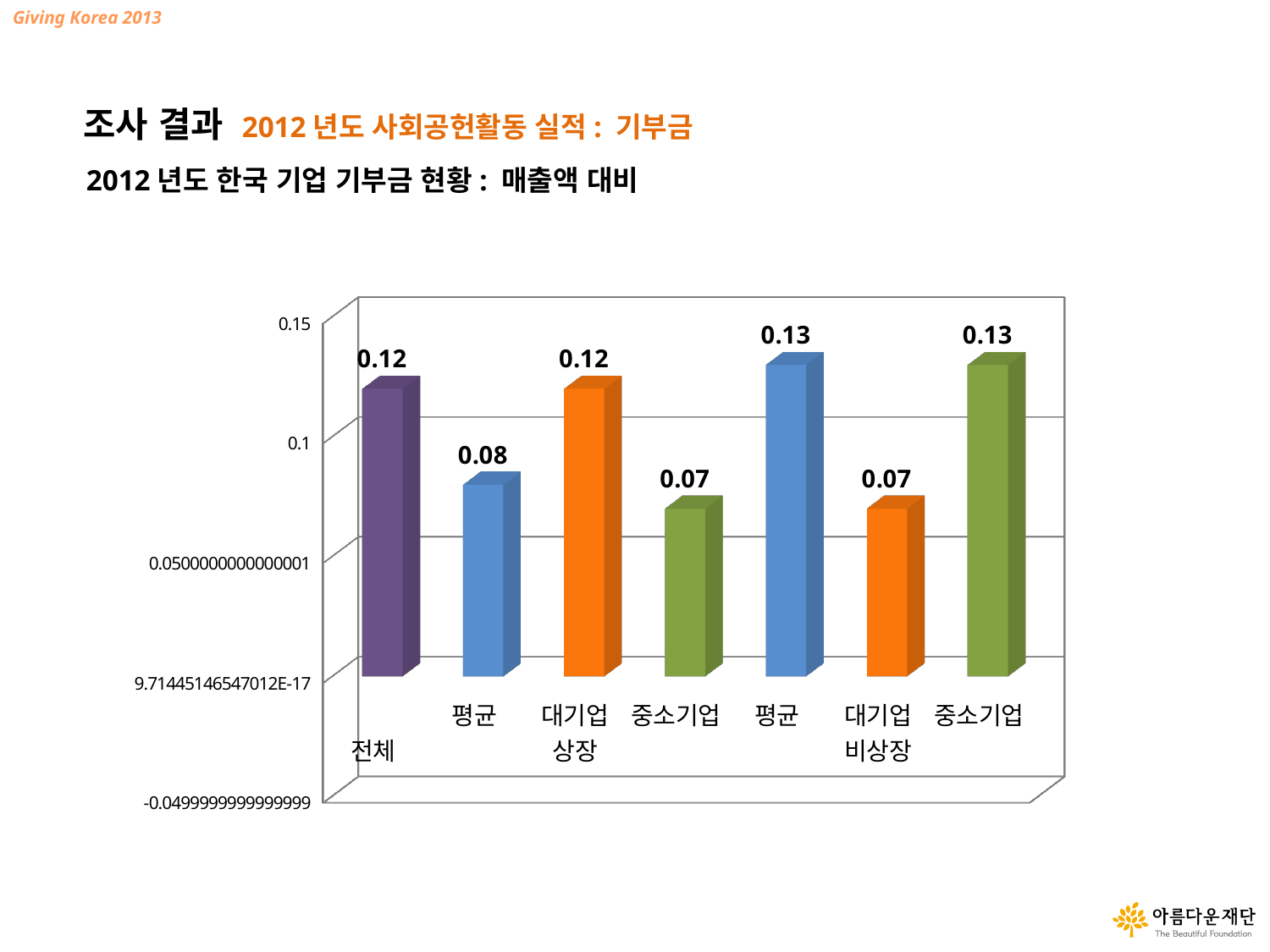
What is the value for 중소기업 in the 비상장 group (rightmost bar)? 0.13 What is the value for 대기업 상장? 0.12 What is the title of the chart? 2012 년도 한국 기업 기부금 현황 : 매출액 대비 What is the value for the 평균 bar in the 상장 group (second bar from the left)? 0.08 How many bars are plotted in the chart? 7 Which is larger, the value for 대기업 상장 or the value for 중소기업 in the 상장 group? 대기업 상장 Is the value for 전체 greater or less than 0.1? greater What is the difference between the 평균 bar in the 비상장 group and the 대기업 비상장 bar? 0.06 What kind of chart is shown on the slide? bar chart What is the difference between the value for 전체 and the value for the 평균 bar in the 상장 group? 0.04 What is the value for 전체? 0.12 What is the value for 대기업 비상장? 0.07